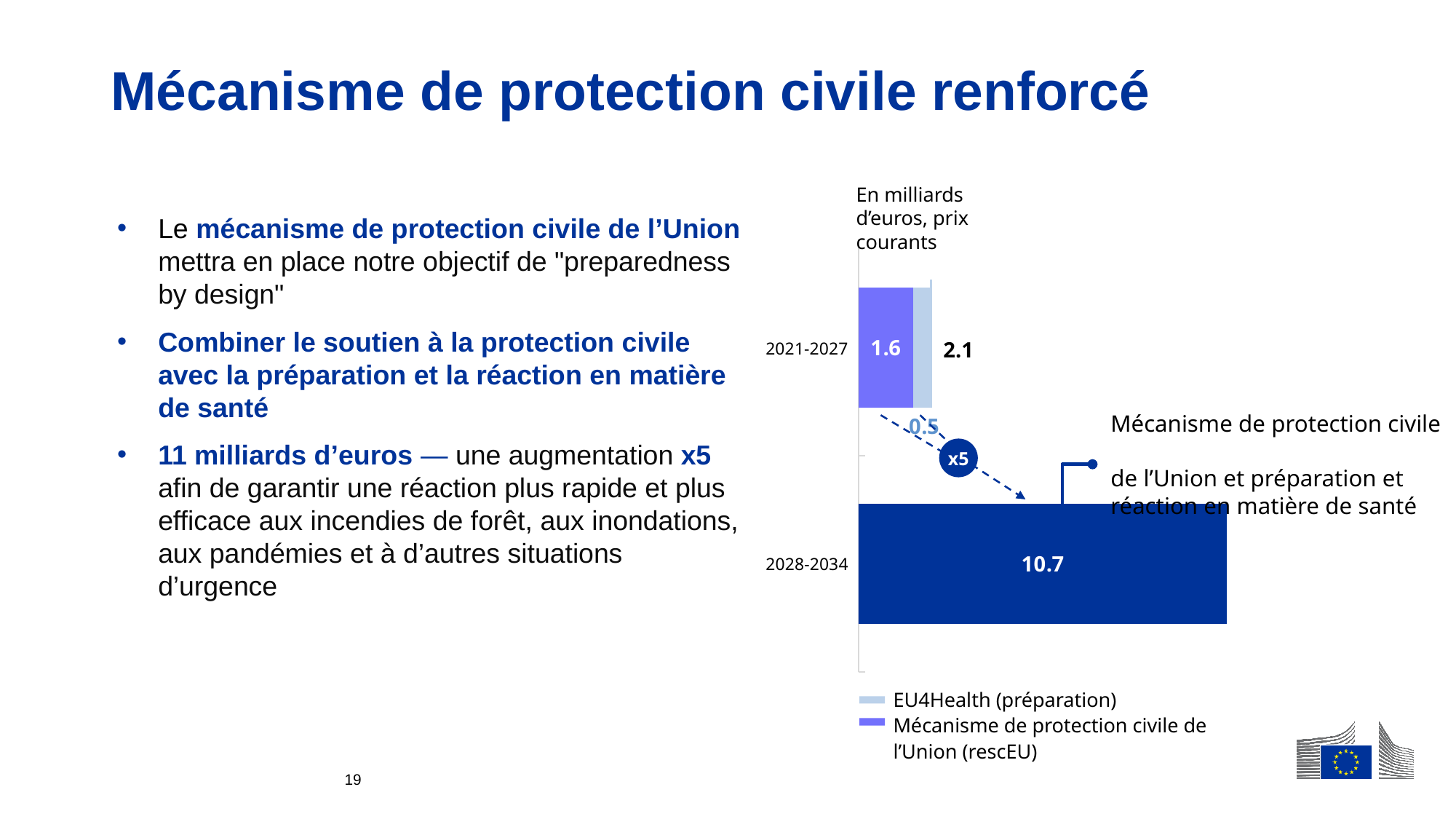
Which period has the highest total value? 2028-2034 How many series does the legend list? 2 Which period has the larger bar, 2021-2027 or 2028-2034? 2028-2034 What is the value shown for the 2028-2034 bar? 10.7 What is the value for EU4Health (préparation) in 2021-2027? 0.5 What is the difference between the 2028-2034 value (10.7) and the 2021-2027 total (2.1)? 8.6 What multiplier is shown in the circle between the two bars? x5 In what unit are the chart values expressed, according to the label above the chart? En milliards d'euros, prix courants What kind of chart is shown on the slide? Bar chart What is the total value shown for the 2021-2027 bar? 2.1 How many periods (categories) are shown on the chart? 2 What is the value for Mécanisme de protection civile de l'Union (rescEU) in 2021-2027? 1.6